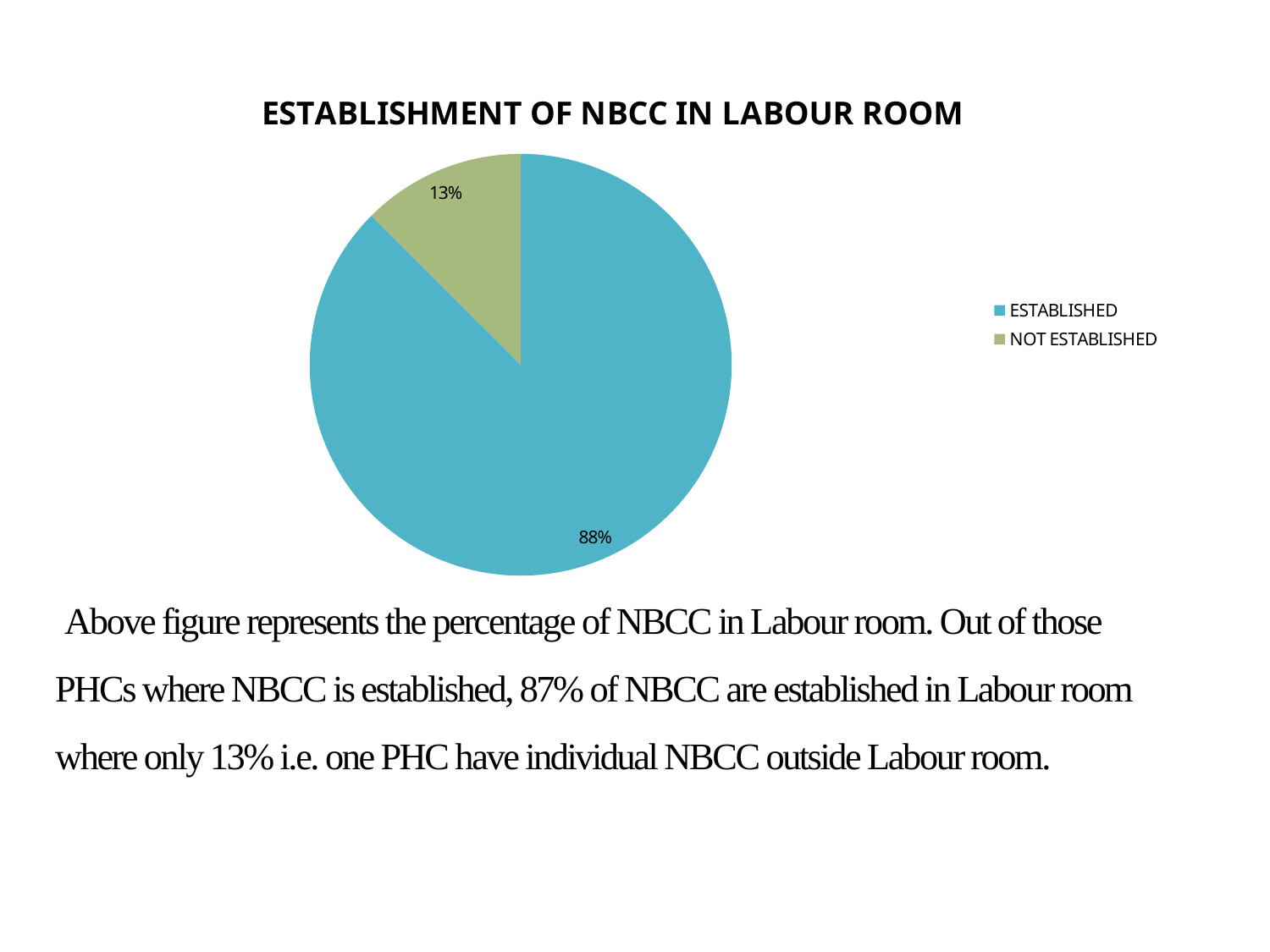
What is the title of the chart? ESTABLISHMENT OF NBCC IN LABOUR ROOM What percentage of the pie is labelled for ESTABLISHED? 88% Which is larger, the ESTABLISHED slice or the NOT ESTABLISHED slice? ESTABLISHED What share of the pie does the NOT ESTABLISHED slice represent? 13% How many entries does the legend list? 2 What colour is the ESTABLISHED slice in the pie chart? blue What percentage of the pie is labelled for NOT ESTABLISHED? 13% How many slices does the pie chart have? 2 What kind of chart is shown on the slide? pie chart Which category has the smallest slice of the pie? NOT ESTABLISHED Which category has the largest slice of the pie? ESTABLISHED What is the difference in percentage points between the ESTABLISHED and NOT ESTABLISHED slices? 75